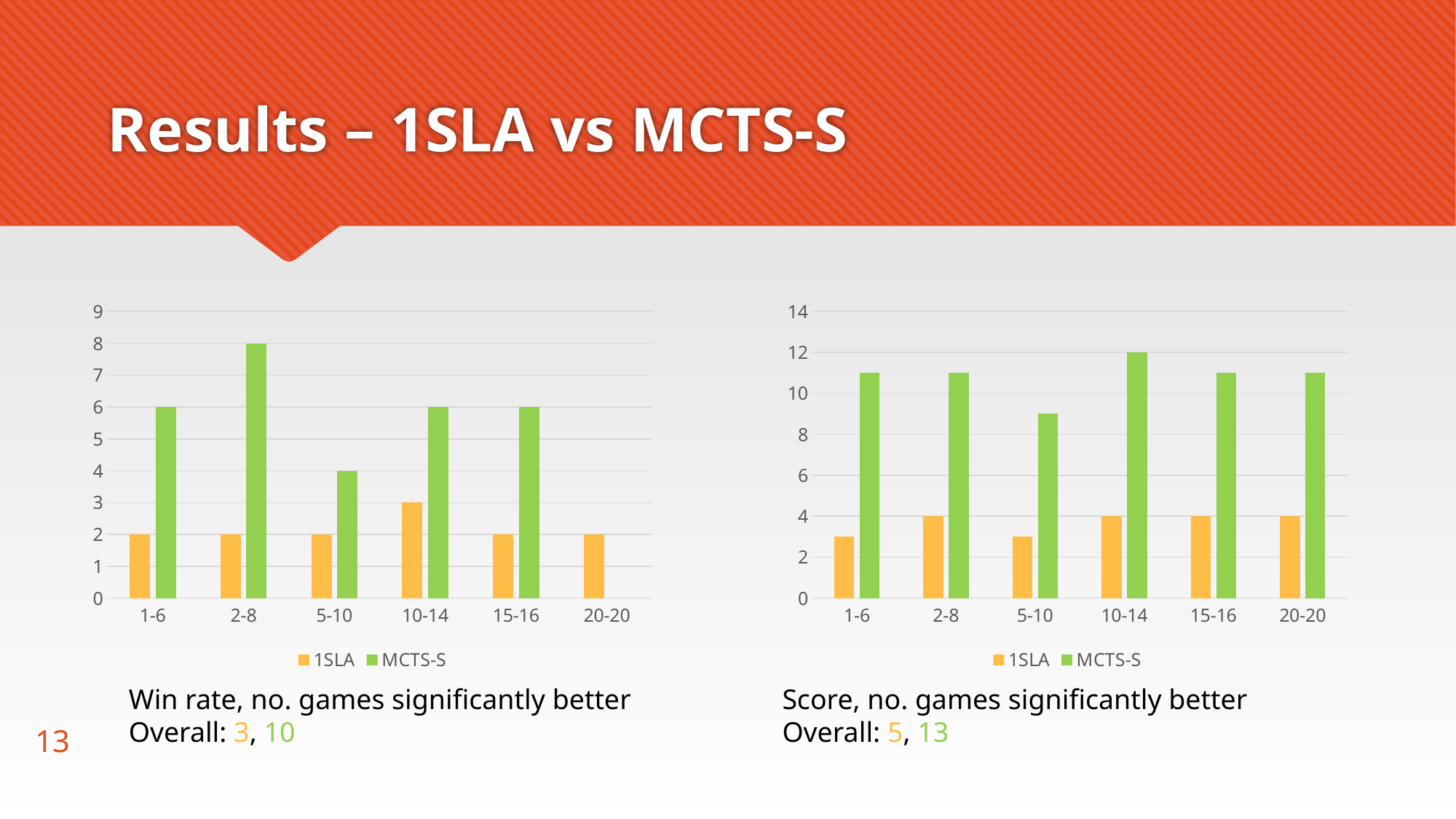
In the right chart (Score), which category has the lowest MCTS-S value? 5-10 In the right chart (Score), which is larger at 1-6, 1SLA or MCTS-S? MCTS-S What kind of chart is the left chart (Win rate)? bar chart How many series does the legend of the right chart (Score) list? 2 In the left chart (Win rate), how many categories are shown on the x axis? 6 In the left chart (Win rate), what is the difference between MCTS-S and 1SLA at 2-8? 6 In the right chart (Score), is the value for MCTS-S at 5-10 greater or less than 10? less In the right chart (Score), what is the value for 1SLA at 2-8? 4 In the left chart (Win rate), what is the value for MCTS-S at 2-8? 8 In the right chart (Score), what is the value for MCTS-S at 10-14? 12 In the left chart (Win rate), which category has the highest MCTS-S value? 2-8 In the left chart (Win rate), what is the value for 1SLA at 10-14? 3